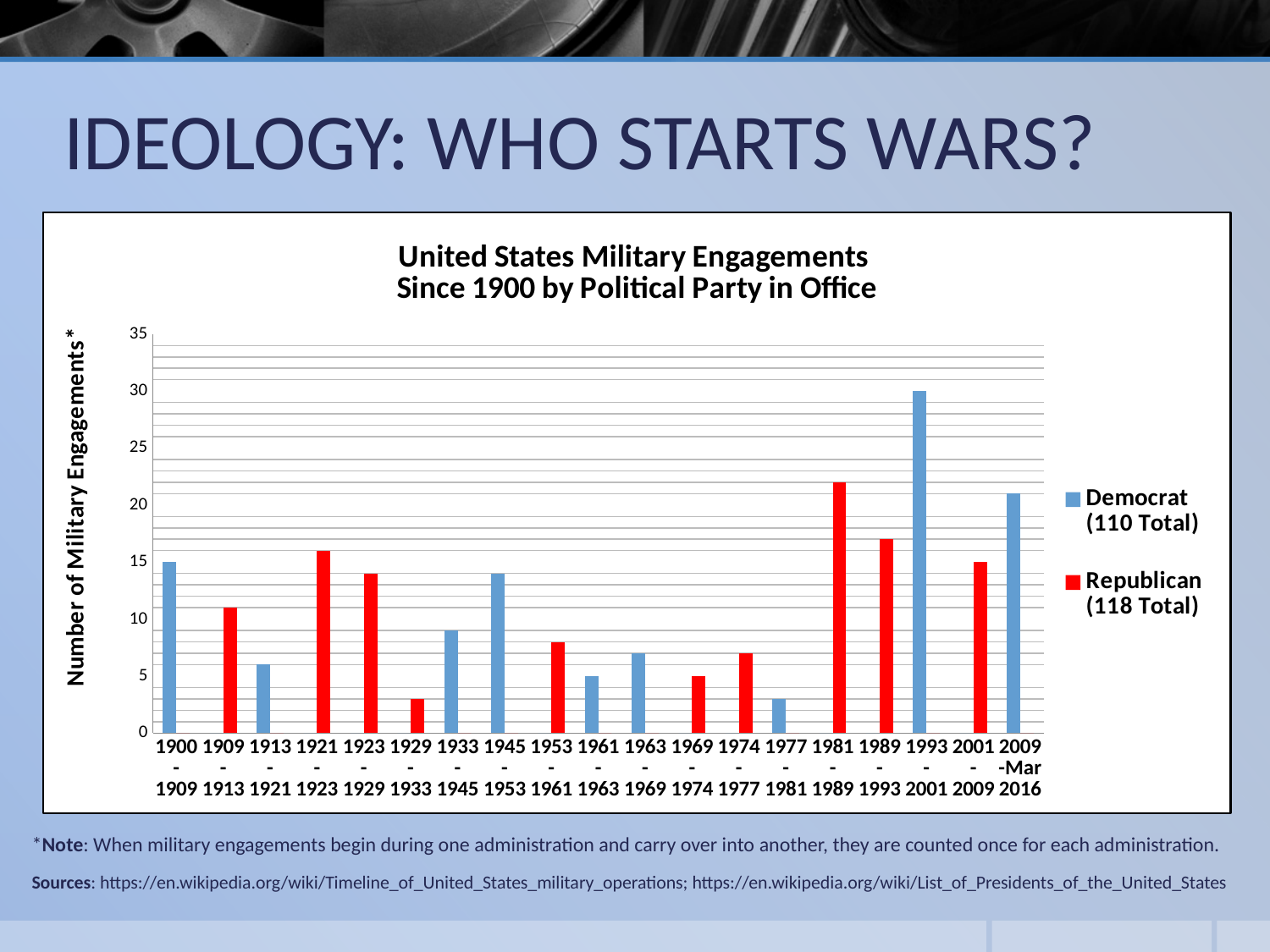
How many administration periods (categories) are shown on the x axis? 19 Is the value for the 1909-1913 period greater or less than 10? greater According to the legend, what is the total number of military engagements under Republican administrations? 118 Is the value for the 1929-1933 period greater or less than 5? less How many series does the legend list? 2 Which period has more military engagements, 1981-1989 or 1989-1993? 1981-1989 Is the value for the 1981-1989 period greater or less than 20? greater Which period has more military engagements, 1900-1909 or 1913-1921? 1900-1909 How many military engagements are shown for the 1993-2001 period? 30 Which administration period has the highest number of military engagements? 1993-2001 According to the legend totals, how many more military engagements occurred under Republican administrations than under Democrat administrations? 8 What type of chart is shown on the slide? bar chart